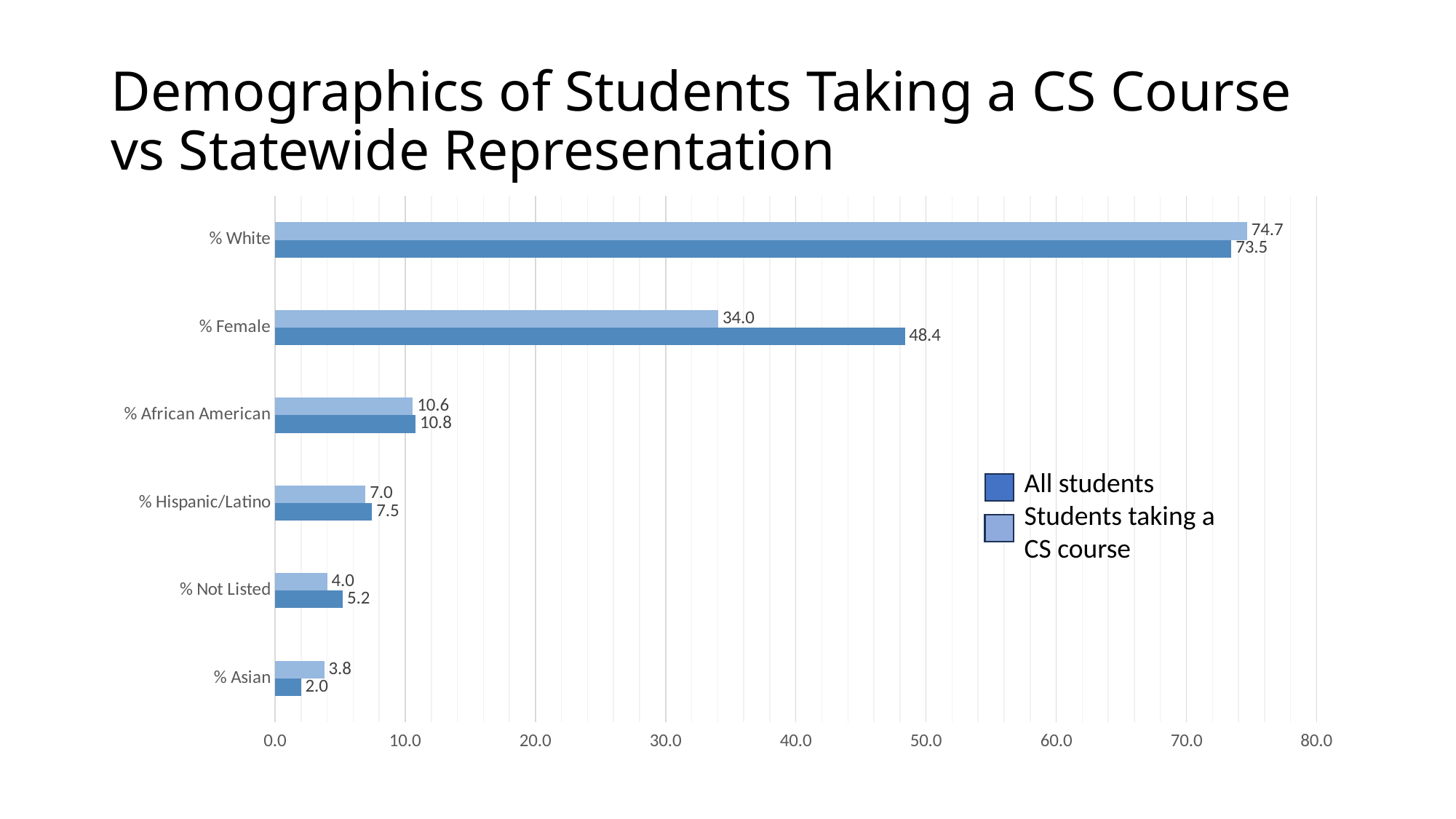
What is the value for % Asian in the 'All students' series? 2.0 How many categories are shown on the chart? 6 For % Asian, which series has the larger value: 'All students' or 'Students taking a CS course'? Students taking a CS course What type of chart is shown on the slide? Bar chart Which series is shown in the darker blue colour? All students What is the value for % Female in the 'Students taking a CS course' series? 34.0 How many series does the legend list? 2 Which category has the lowest value in the 'Students taking a CS course' series? % Asian What is the value for % White in the 'Students taking a CS course' series? 74.7 What is the value for % Female in the 'All students' series? 48.4 Which category has the highest value in the 'All students' series? % White What is the difference between the 'All students' and 'Students taking a CS course' values for % Female? 14.4